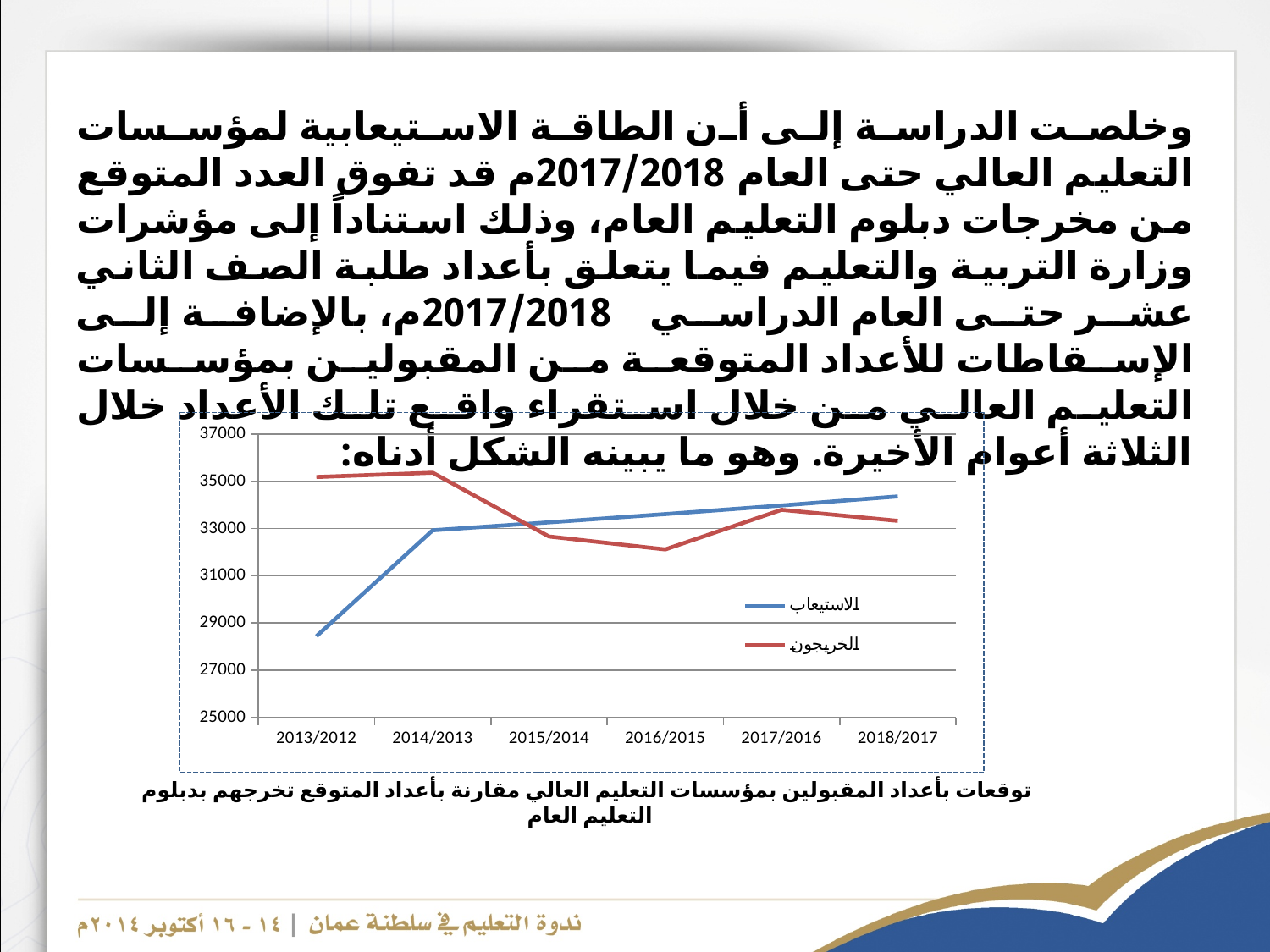
Is the value of الخريجون for 2013/2012 greater or less than 33000? greater Which series is drawn in red in the chart? الخريجون In 2018/2017, which series has the larger value, الاستيعاب or الخريجون? الاستيعاب Is the value of الاستيعاب for 2013/2012 greater or less than 29000? less Does the الاستيعاب series rise or fall from 2013/2012 to 2018/2017? rise Is the value of الخريجون for 2016/2015 greater or less than 33000? less What kind of chart is shown on the slide? line chart In 2013/2012, which series has the larger value, الاستيعاب or الخريجون? الخريجون How many series does the chart legend list? 2 How many academic years are shown on the x axis of the chart? 6 Which series is drawn in blue in the chart? الاستيعاب